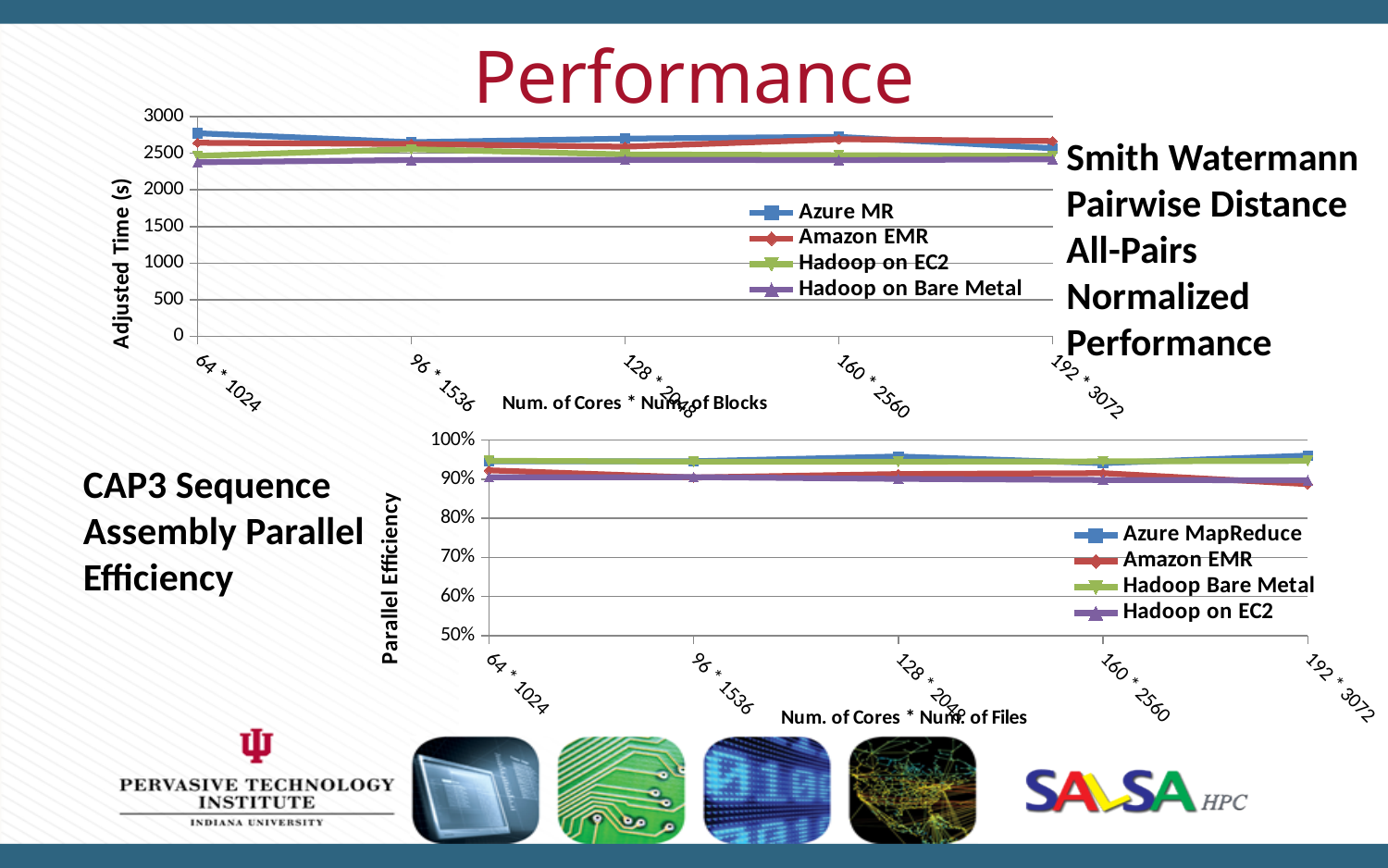
What kind of chart is the CAP3 Sequence Assembly Parallel Efficiency chart at the bottom of the slide? Line chart What is the y-axis title of the top chart (Smith Watermann)? Adjusted Time (s) How many categories are shown on the x axis of the top chart (Smith Watermann)? 5 How many series does the legend of the bottom chart (CAP3 Sequence Assembly Parallel Efficiency) list? 4 What kind of chart is the Smith Watermann Pairwise Distance All-Pairs Normalized Performance chart at the top of the slide? Line chart How many series does the legend of the top chart (Smith Watermann) list? 4 What is the x-axis title of the bottom chart (CAP3 Sequence Assembly Parallel Efficiency)? Num. of Cores * Num. of Files In the bottom chart (CAP3 Sequence Assembly Parallel Efficiency), is the value for Azure MapReduce at 64 * 1024 greater or less than 90%? greater In the top chart (Smith Watermann), which series has the highest value at 64 * 1024? Azure MR In the top chart (Smith Watermann), is the value for Azure MR at 64 * 1024 greater or less than 2500? greater In the top chart (Smith Watermann), is the value for Hadoop on Bare Metal at 64 * 1024 greater or less than 2500? less In the bottom chart (CAP3 Sequence Assembly Parallel Efficiency), which is larger at 64 * 1024: Azure MapReduce or Hadoop on EC2? Azure MapReduce